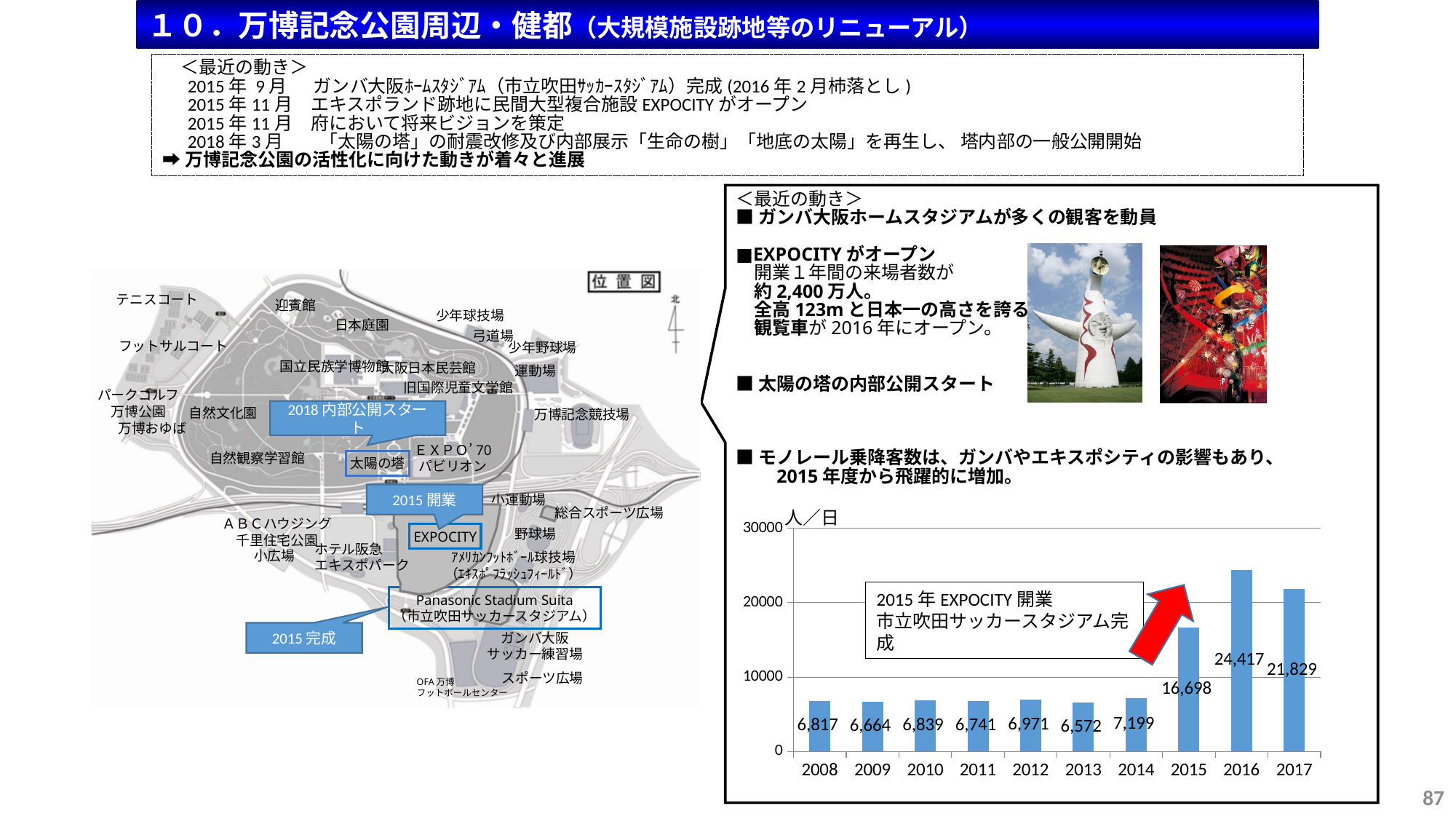
What unit label is shown at the top of the y axis of the bar chart? 人／日 In the bar chart, what is the value for 2008? 6,817 In the bar chart, what is the value for 2015? 16,698 Which year has the highest value in the bar chart? 2016 In the bar chart, what is the value for 2013? 6,572 In the bar chart, which is larger, the value for 2014 or the value for 2015? 2015 In the bar chart, what is the value for 2016? 24,417 What type of chart is shown at the bottom right of the slide? bar chart How many years are shown on the x axis of the bar chart? 10 Which year has the lowest value in the bar chart? 2013 Is the value for 2017 in the bar chart greater or less than 20000? greater What is the difference between the 2016 and 2017 values in the bar chart? 2,588